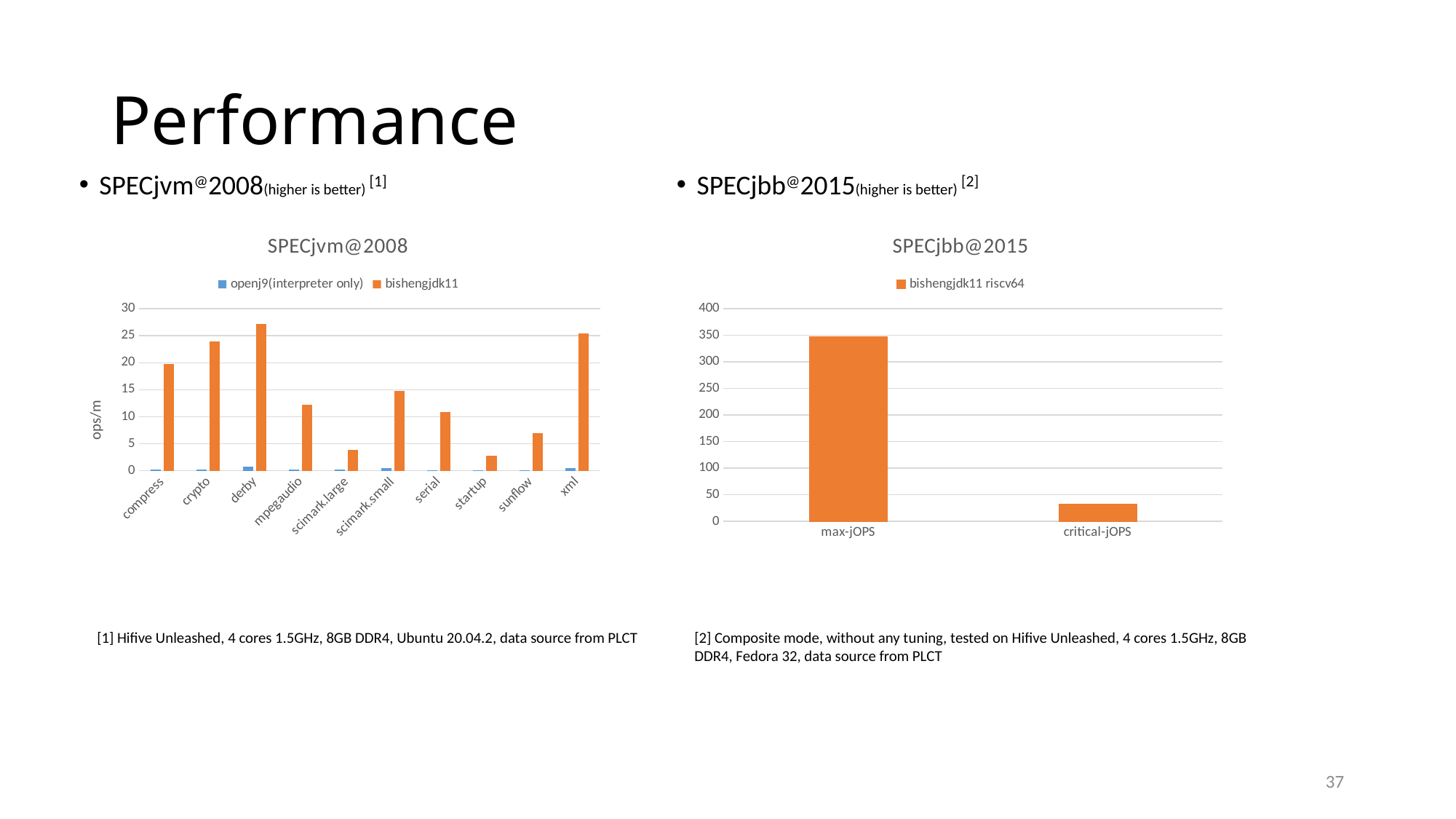
In the SPECjbb@2015 chart, which category has the lower value, max-jOPS or critical-jOPS? critical-jOPS What is the y-axis label of the SPECjvm@2008 chart? ops/m What kind of chart is the SPECjbb@2015 chart? bar chart In the SPECjvm@2008 chart, which category has the lowest bishengjdk11 value? startup In the SPECjbb@2015 chart, is the value for max-jOPS greater or less than 300? greater How many series does the legend of the SPECjvm@2008 chart list? 2 In the SPECjvm@2008 chart, is the bishengjdk11 value for compress greater or less than 15? greater In the SPECjvm@2008 chart, which category has the highest bishengjdk11 value? derby In the SPECjvm@2008 chart, is the bishengjdk11 value for derby greater or less than 25? greater How many categories are shown on the x axis of the SPECjvm@2008 chart? 10 In the SPECjvm@2008 chart, which has the larger bishengjdk11 value, crypto or serial? crypto